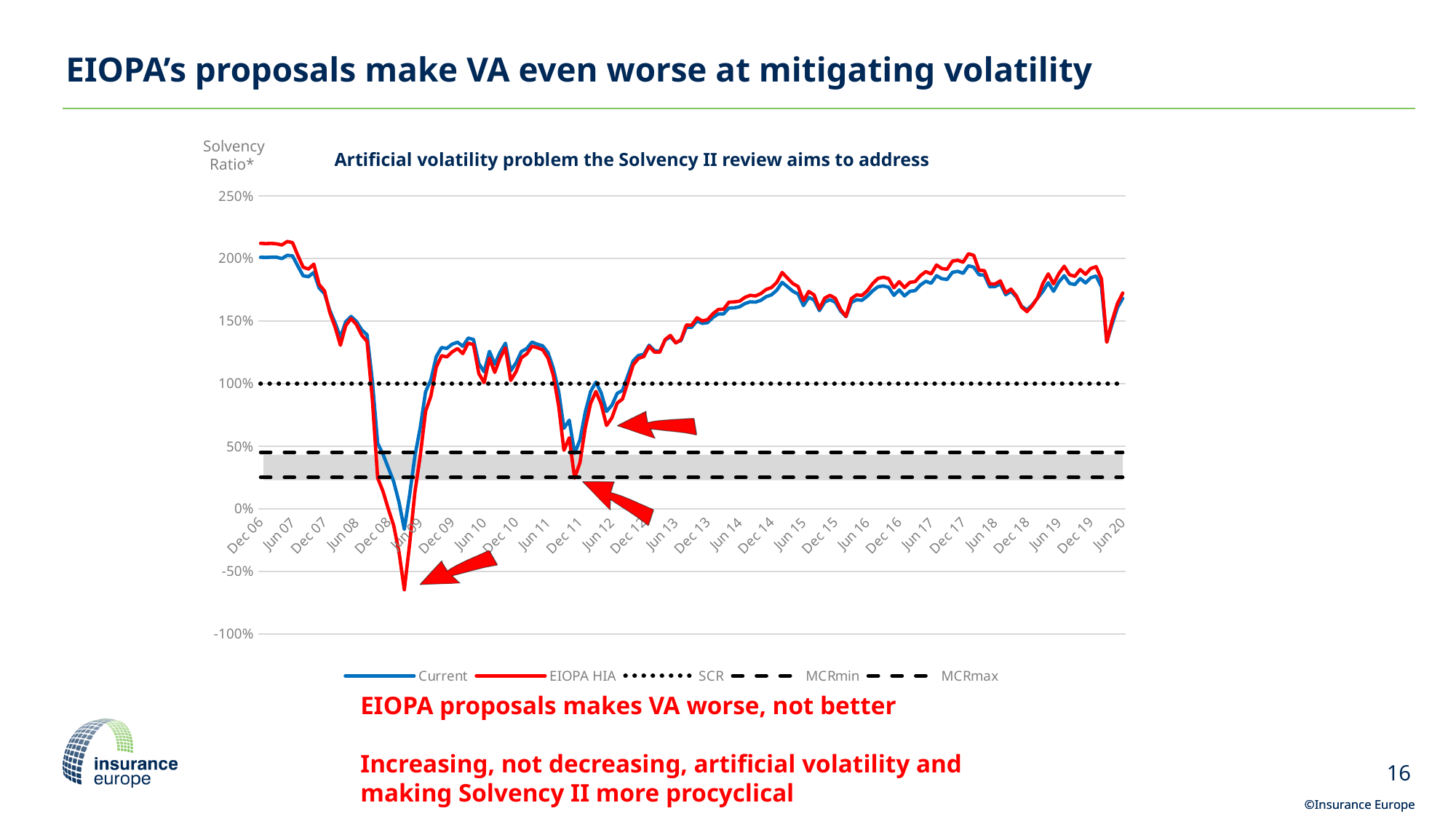
At what level is the SCR dotted line drawn on the chart? 100% At Dec 11, which series is lower, Current or EIOPA HIA? EIOPA HIA What colour is the Current series line? Blue Is the value of the Current series at Dec 06 greater or less than 150%? greater How many date labels are shown on the x axis? 28 Is the value of the EIOPA HIA series at Dec 11 greater or less than 50%? less What kind of chart is shown on the slide? Line chart What is the title of the chart? Artificial volatility problem the Solvency II review aims to address How many series does the chart legend list? 5 Does the Current series rise or fall between Dec 11 and Dec 14? Rise Is the value of the Current series at Dec 14 greater or less than 150%? greater